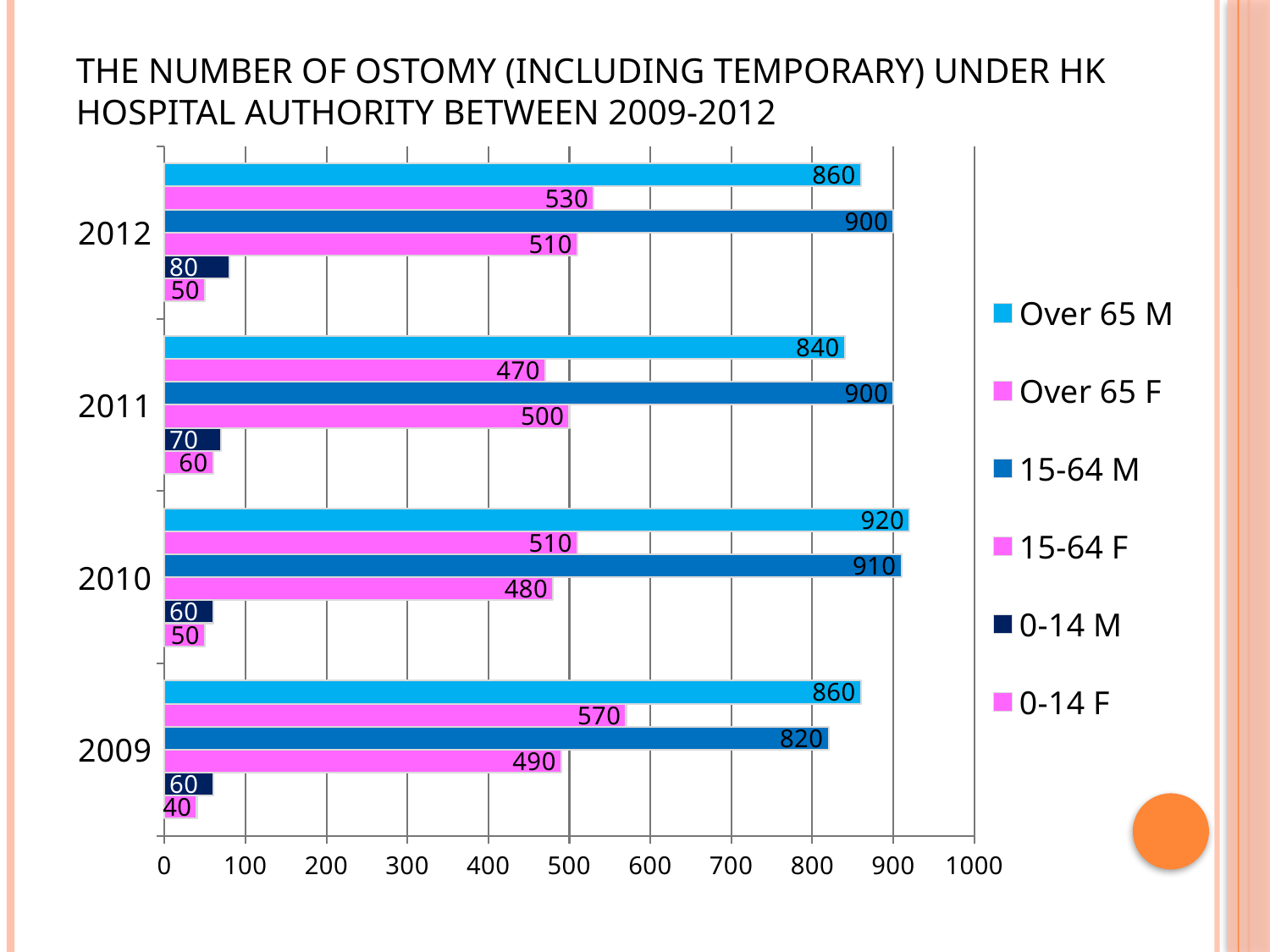
What is the value for 15-64 F in 2010? 480 Does the 15-64 M value rise or fall from 2009 to 2010? rise What is the title of the chart? The number of ostomy (including temporary) under HK Hospital Authority between 2009-2012 Which is larger in 2012: Over 65 M or 15-64 M? 15-64 M What kind of chart is shown on the slide? bar chart How many series does the legend list? 6 In which year is the Over 65 M value highest? 2010 How many years are shown on the vertical axis? 4 In which year is the 15-64 M value lowest? 2009 What is the value for 0-14 F in 2009? 40 What is the value for Over 65 M in 2012? 860 What is the difference between the Over 65 F values in 2009 and 2011? 100